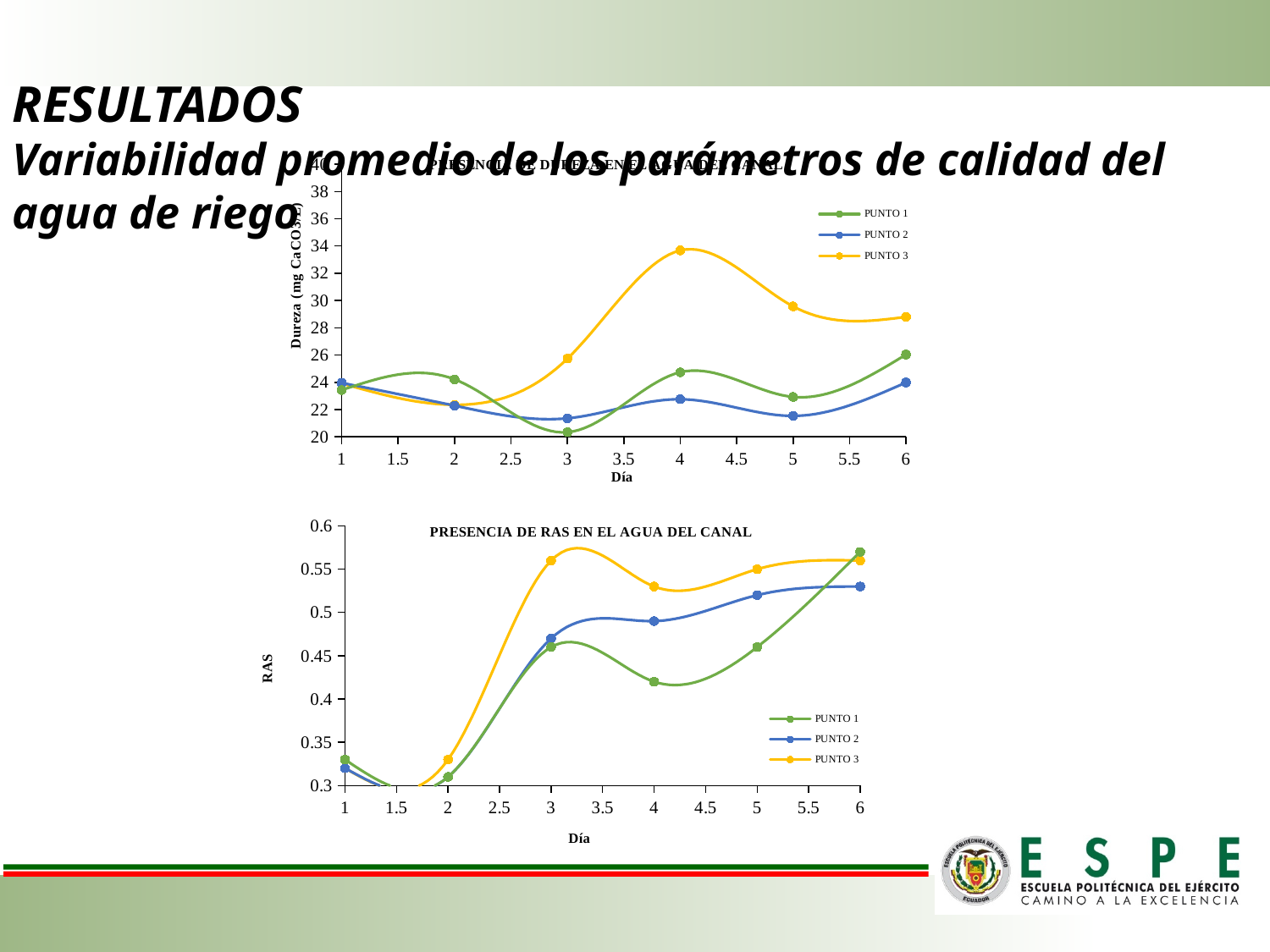
In the bottom chart 'PRESENCIA DE RAS EN EL AGUA DEL CANAL', how many days (data points per series) are plotted? 6 In the top chart, is the value for PUNTO 3 on day 4 greater or less than 30? greater What kind of chart is the bottom chart titled 'PRESENCIA DE RAS EN EL AGUA DEL CANAL'? line chart In the top chart, is the value for PUNTO 1 on day 3 greater or less than 22? less In the bottom chart 'PRESENCIA DE RAS EN EL AGUA DEL CANAL', does the PUNTO 2 series rise or fall overall from day 1 to day 6? rise In the bottom chart 'PRESENCIA DE RAS EN EL AGUA DEL CANAL', is the value for PUNTO 1 on day 4 greater or less than 0.45? less In the bottom chart 'PRESENCIA DE RAS EN EL AGUA DEL CANAL', which series has the lowest value on day 4? PUNTO 1 What is the label of the x axis in the bottom chart 'PRESENCIA DE RAS EN EL AGUA DEL CANAL'? Día In the top chart, which is larger on day 6: PUNTO 3 or PUNTO 2? PUNTO 3 In the top chart, which series has the highest value on day 4? PUNTO 3 How many series does the legend of the top chart list? 3